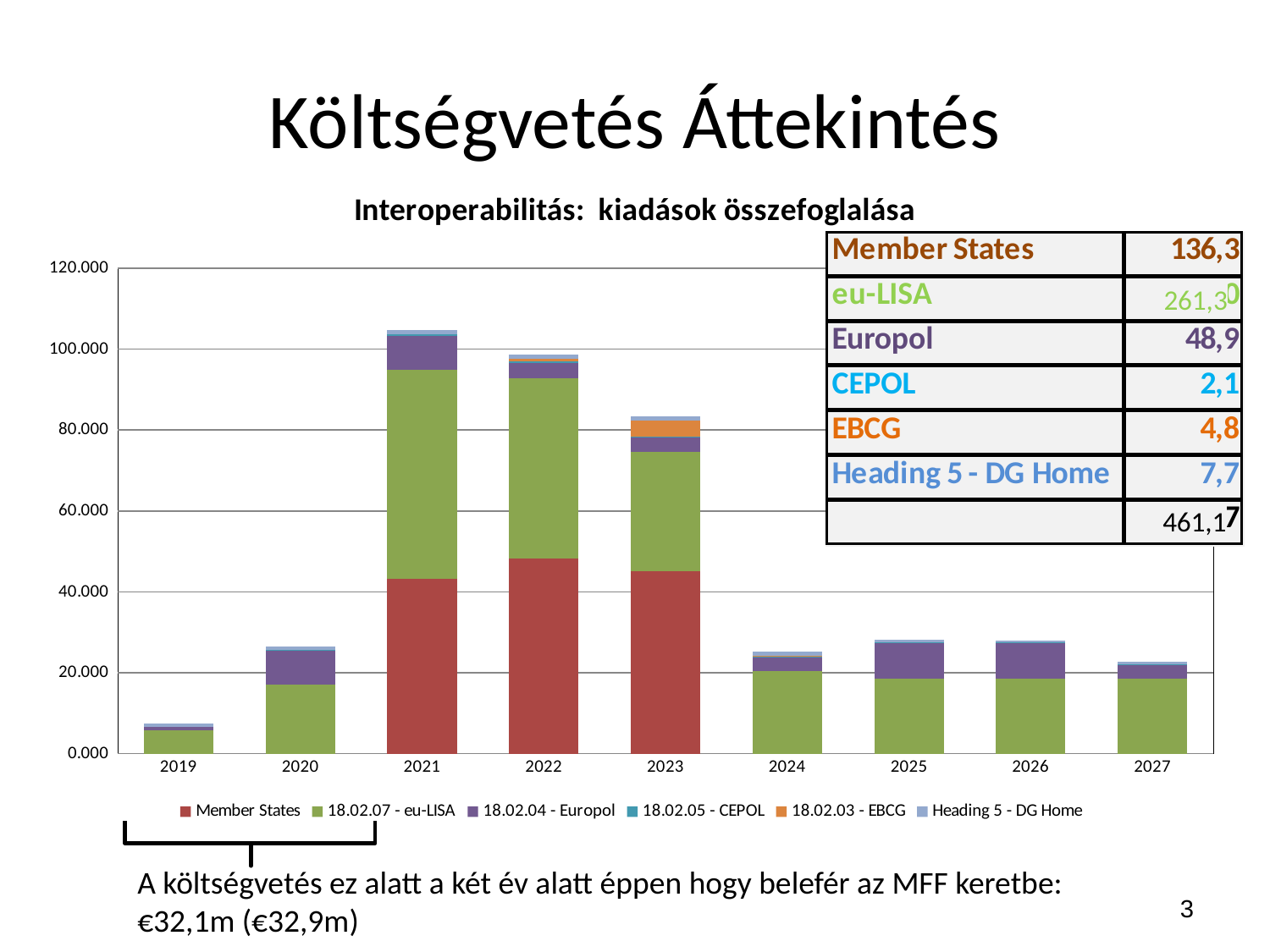
What kind of chart is shown on the slide? bar chart Which year has the shortest stacked bar? 2019 Is the total of the 2021 bar greater or less than 100.000? greater Is the total of the 2019 bar greater or less than 20.000? less What is the title of the chart? Interoperabilitás: kiadások összefoglalása Do the bar totals rise or fall from 2021 to 2024? fall Is the total of the 2024 bar greater or less than 40.000? less Which year has the larger stacked bar, 2025 or 2027? 2025 How many series does the chart legend list? 6 Which year has the larger stacked bar, 2022 or 2023? 2022 Which year has the tallest stacked bar? 2021 How many years are shown on the x axis of the chart? 9